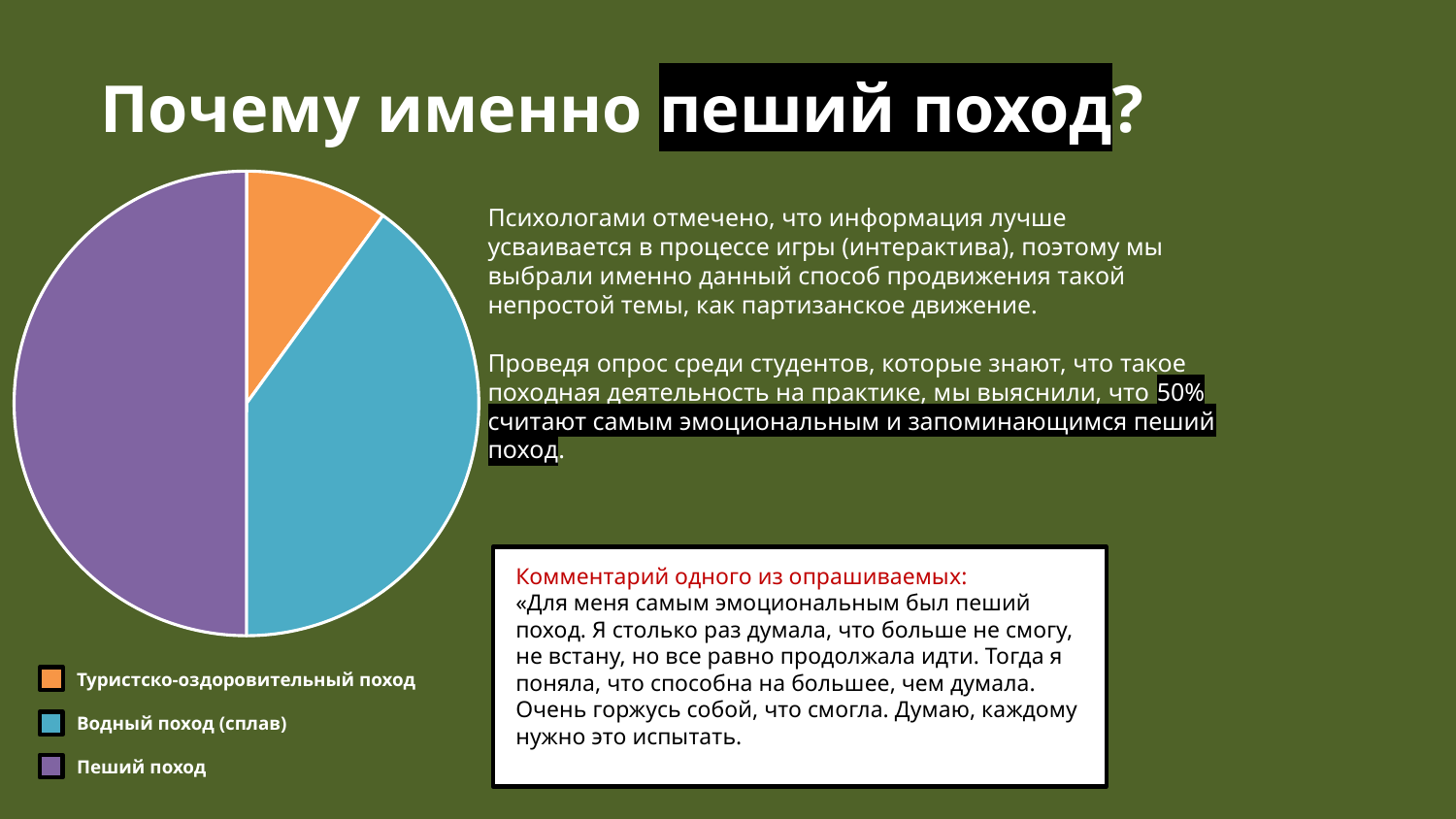
What colour represents Пеший поход in the pie chart? purple How many slices does the pie chart have? 3 Which category has the largest slice in the pie chart? Пеший поход How many entries does the legend of the pie chart list? 3 According to the slide, what share of respondents chose Пеший поход as the most emotional and memorable? 50% What kind of chart is shown on the slide? pie chart Which category is shown in orange in the pie chart? Туристско-оздоровительный поход Which slice is larger: Пеший поход or Водный поход (сплав)? Пеший поход Which category has the smallest slice in the pie chart? Туристско-оздоровительный поход Which slice is larger: Водный поход (сплав) or Туристско-оздоровительный поход? Водный поход (сплав)